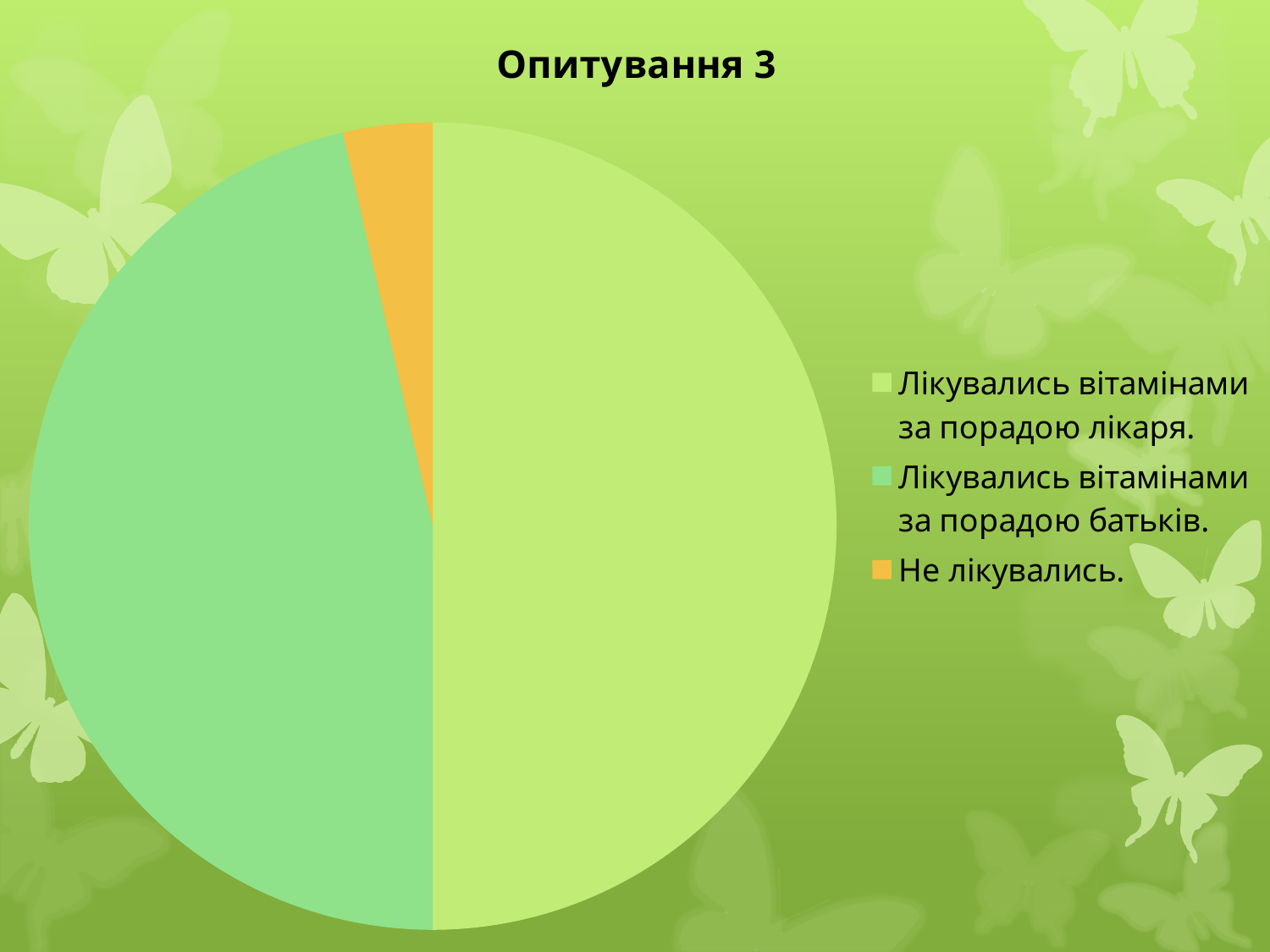
What kind of chart is shown on the slide? pie chart Which slice is larger: "Лікувались вітамінами за порадою лікаря." or "Не лікувались."? Лікувались вітамінами за порадою лікаря. How many entries does the legend list? 3 Which category has the largest slice of the pie? Лікувались вітамінами за порадою лікаря. What colour is the slice for "Не лікувались."? orange Which slice is larger: "Лікувались вітамінами за порадою батьків." or "Не лікувались."? Лікувались вітамінами за порадою батьків. Which category has the smallest slice of the pie? Не лікувались. What is the title of the chart? Опитування 3 How many slices does the pie chart have? 3